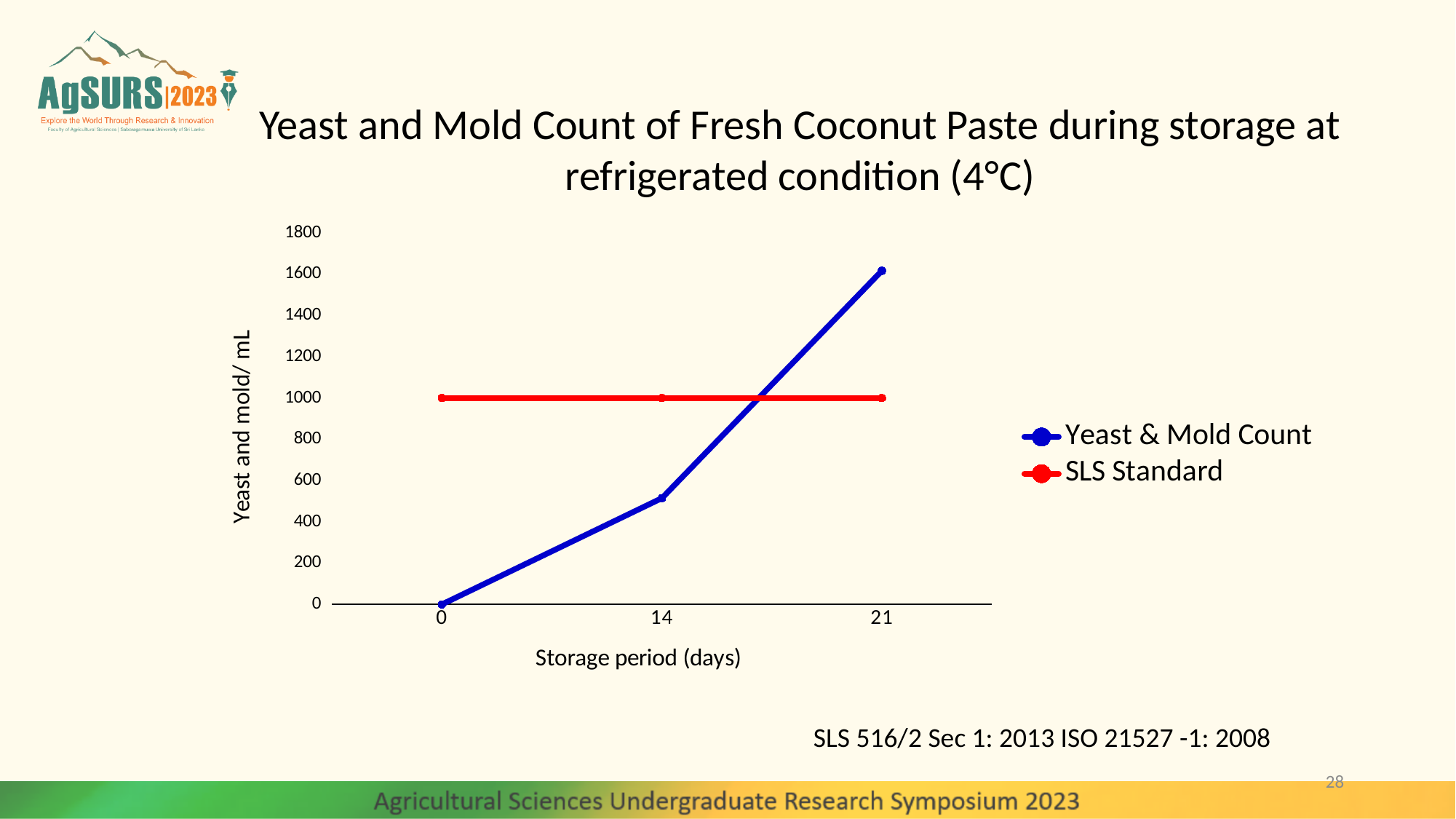
Is the Yeast & Mold Count at 21 days greater or less than 1400? greater What is the value of the SLS Standard line? 1000 How many storage period points are plotted on the x axis? 3 Does the Yeast & Mold Count rise or fall as the storage period increases? rises Is the Yeast & Mold Count at 14 days greater or less than 1000? less At 21 days, which is larger: the Yeast & Mold Count or the SLS Standard? Yeast & Mold Count How many series does the legend list? 2 At 14 days, which is larger: the Yeast & Mold Count or the SLS Standard? SLS Standard What is the Yeast & Mold Count at 0 days of storage? 0 What kind of chart is shown on the slide? line chart What is the title of the x axis? Storage period (days) At which storage period is the Yeast & Mold Count highest? 21